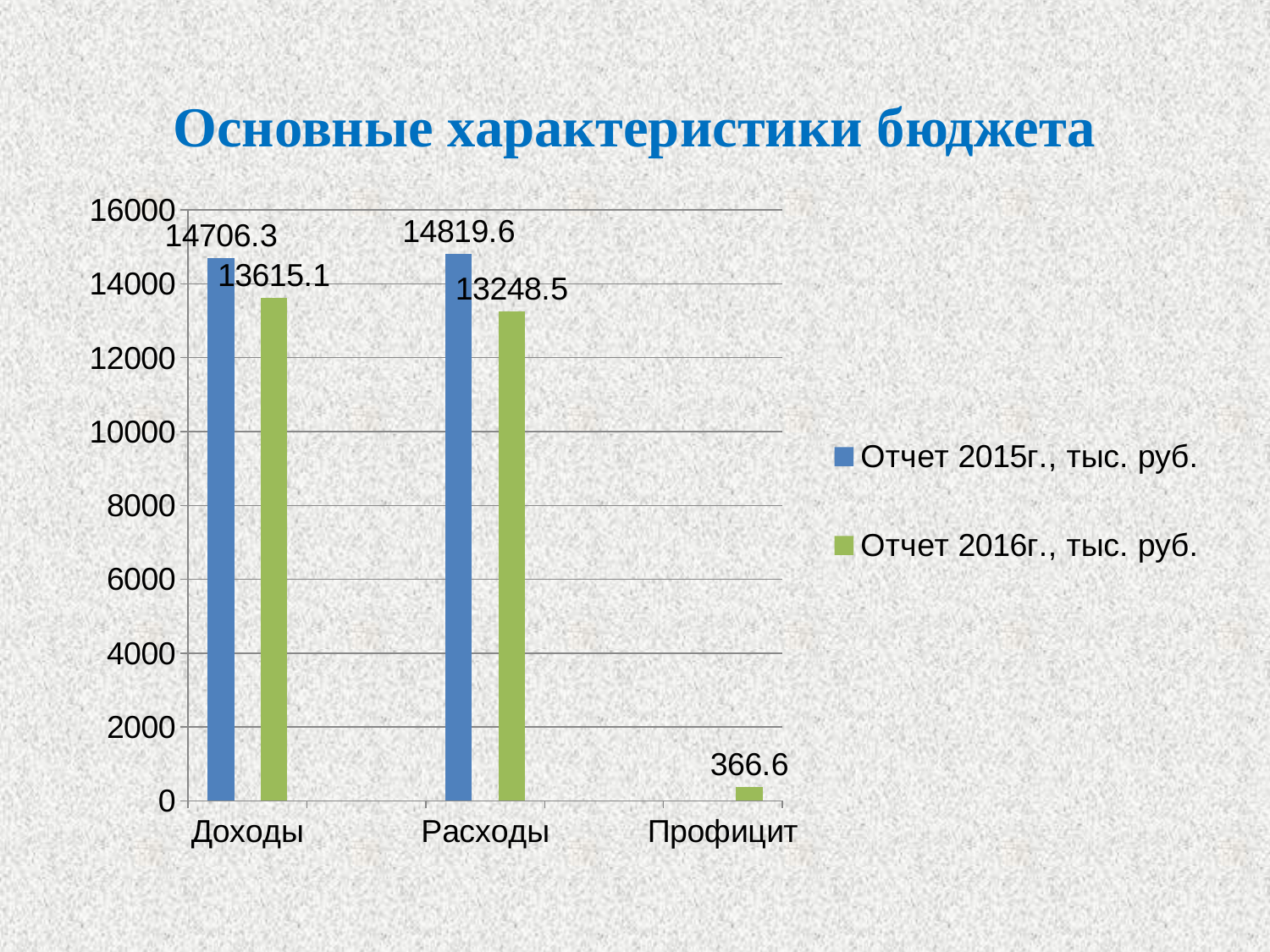
What kind of chart is shown on the slide? Bar chart Which category has the lowest value in the Отчет 2016г., тыс. руб. series? Профицит What is the value for Доходы in the Отчет 2016г., тыс. руб. series? 13615.1 What is the value for Доходы in the Отчет 2015г., тыс. руб. series? 14706.3 What is the value for Расходы in the Отчет 2015г., тыс. руб. series? 14819.6 What is the value for Профицит in the Отчет 2016г., тыс. руб. series? 366.6 What is the value for Расходы in the Отчет 2016г., тыс. руб. series? 13248.5 Which is larger: Доходы or Расходы in the Отчет 2016г., тыс. руб. series? Доходы How many categories are shown on the x axis? 3 What is the difference between the Отчет 2015г. and Отчет 2016г. values for Доходы? 1091.2 What is the difference between the Отчет 2015г. and Отчет 2016г. values for Расходы? 1571.1 How many series does the legend list? 2